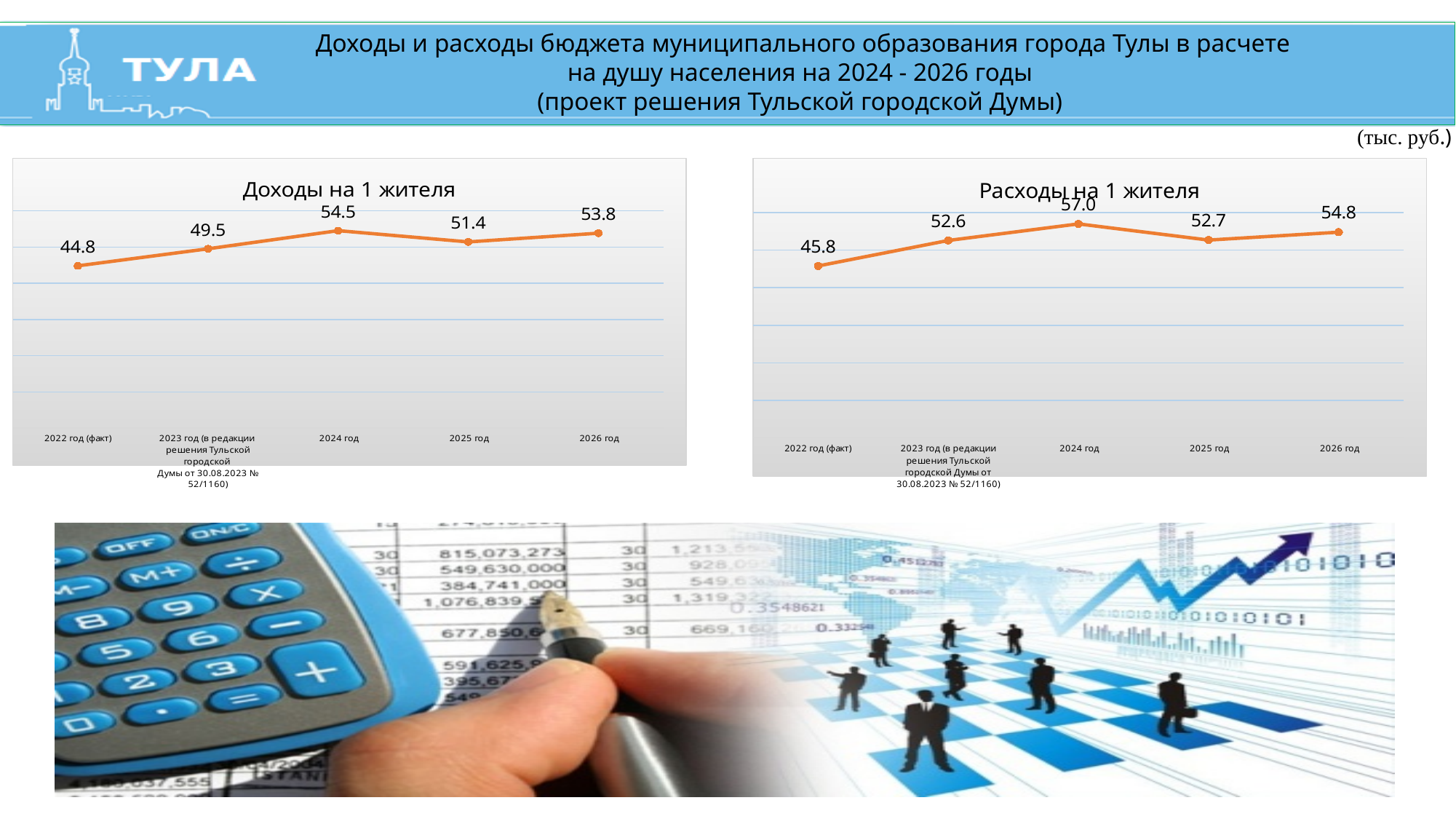
In the chart titled "Доходы на 1 жителя", what is the difference between the values for 2026 год and 2022 год (факт)? 9.0 In the chart titled "Доходы на 1 жителя", does the value rise or fall from 2024 год to 2025 год? Fall In the chart titled "Доходы на 1 жителя", which category has the highest value? 2024 год In the chart titled "Расходы на 1 жителя", what is the difference between the values for 2024 год and 2025 год? 4.3 In the chart titled "Доходы на 1 жителя", what is the value for 2024 год? 54.5 In the chart titled "Расходы на 1 жителя", which is larger: the value for 2023 год or the value for 2026 год? 2026 год In the chart titled "Расходы на 1 жителя", which category has the lowest value? 2022 год (факт) What type of chart is the chart titled "Доходы на 1 жителя"? Line chart What is the title of the chart on the right side of the slide? Расходы на 1 жителя In the chart titled "Доходы на 1 жителя", which is larger: the value for 2025 год or the value for 2023 год? 2025 год In the chart titled "Расходы на 1 жителя", what is the value for 2022 год (факт)? 45.8 How many data points are plotted in the chart titled "Расходы на 1 жителя"? 5